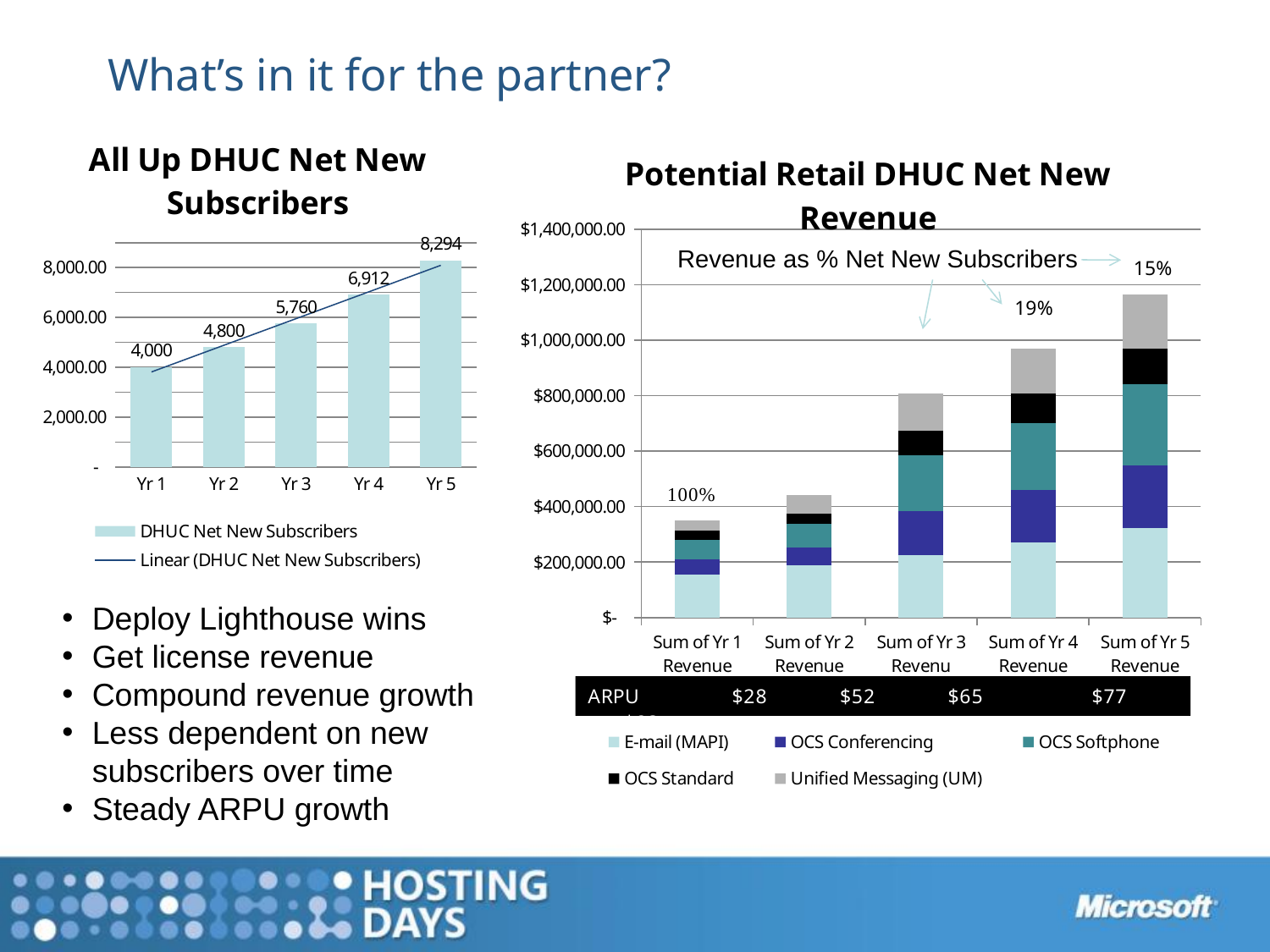
In the All Up DHUC Net New Subscribers chart, what is the value for Yr 5? 8,294 In the Potential Retail DHUC Net New Revenue chart, is the total for Sum of Yr 1 Revenue greater or less than $400,000.00? less In the All Up DHUC Net New Subscribers chart, which year has the highest number of subscribers? Yr 5 In the Potential Retail DHUC Net New Revenue chart, which category has the tallest stacked bar? Sum of Yr 5 Revenue In the All Up DHUC Net New Subscribers chart, which year has the lowest number of subscribers? Yr 1 In the All Up DHUC Net New Subscribers chart, what is the value for Yr 3? 5,760 What kind of chart is the Potential Retail DHUC Net New Revenue chart? stacked bar chart In the All Up DHUC Net New Subscribers chart, do the values rise or fall from Yr 1 to Yr 5? rise How many years are shown on the x axis of the All Up DHUC Net New Subscribers chart? 5 In the All Up DHUC Net New Subscribers chart, what is the difference between the Yr 5 and Yr 4 values? 1,382 In the Potential Retail DHUC Net New Revenue chart, is the total for Sum of Yr 5 Revenue greater or less than $1,000,000.00? greater How many series does the legend of the Potential Retail DHUC Net New Revenue chart list? 5